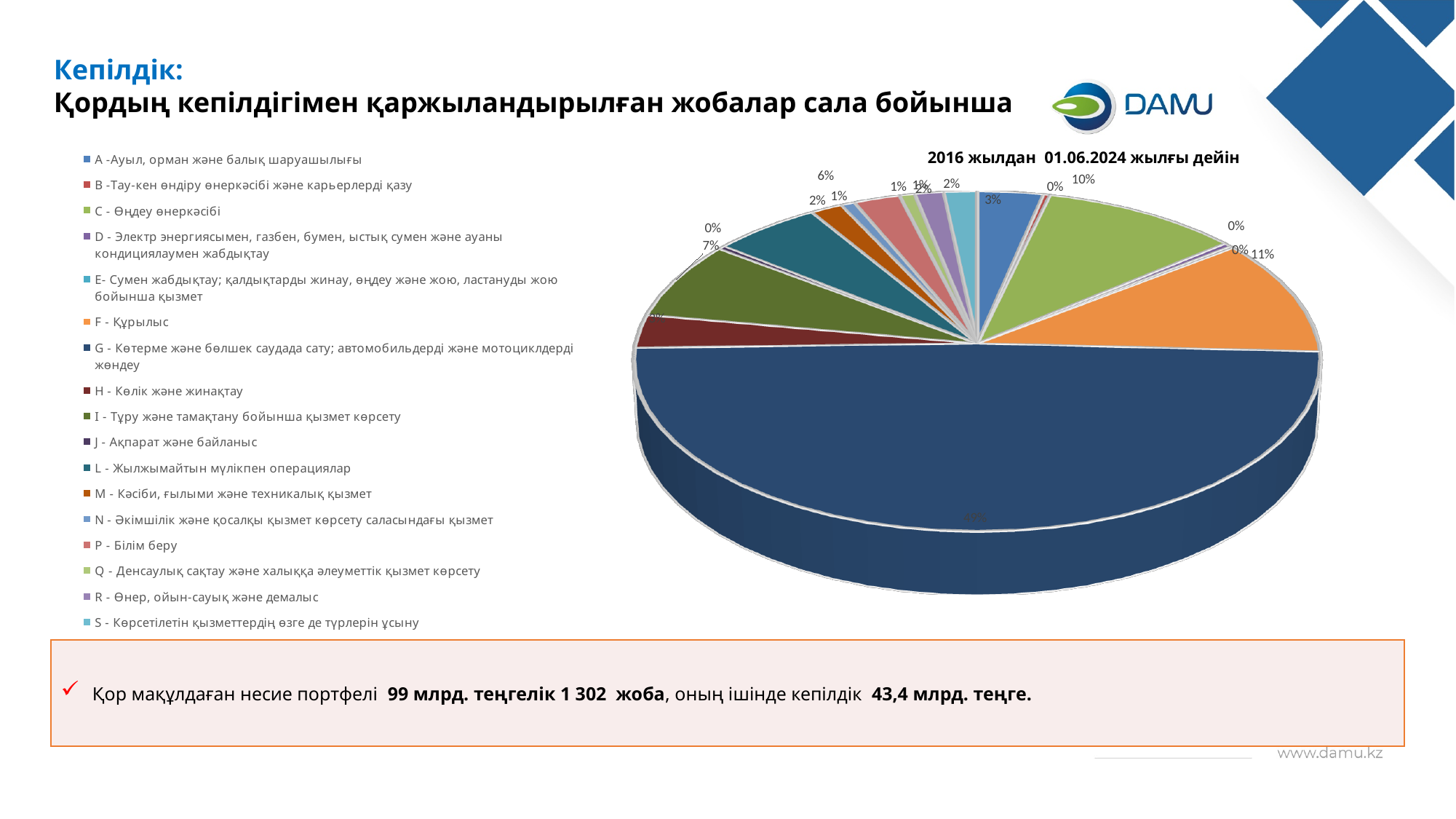
What share of the pie does category G (Көтерме және бөлшек саудада сату) have? 49% How many categories does the legend of the pie chart list? 17 What kind of chart is shown on the slide? pie chart What share of the pie does category F (Құрылыс) have? 11% What share of the pie does category C (Өңдеу өнеркәсібі) have? 10% Which has the larger share: category F (Құрылыс) or category C (Өңдеу өнеркәсібі)? F - Құрылыс Which category has the largest share of the pie? G - Көтерме және бөлшек саудада сату; автомобильдерді және мотоциклдерді жөндеу What is the difference in share between category F (Құрылыс) and category C (Өңдеу өнеркәсібі)? 1% What is the title shown above the pie chart? 2016 жылдан 01.06.2024 жылғы дейін